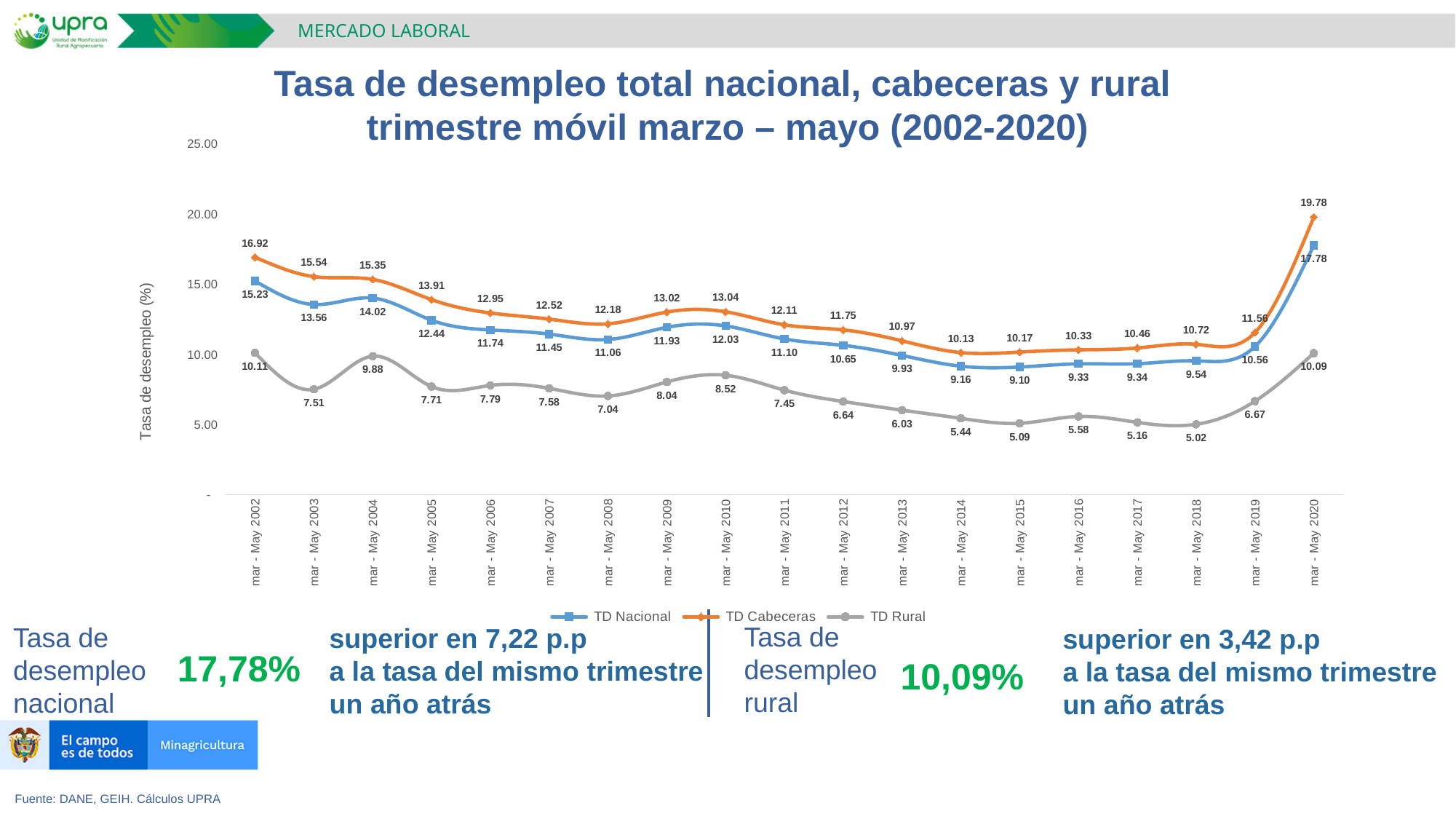
What kind of chart is shown on the slide? line chart By how much did TD Nacional increase from mar - May 2019 to mar - May 2020? 7.22 How many periods are plotted on the x axis? 19 Is the value of TD Cabeceras for mar - May 2002 greater or less than 15.00? greater What is the value of TD Rural for mar - May 2018? 5.02 How many series does the legend list? 3 What is the difference between TD Cabeceras and TD Nacional in mar - May 2020? 2.00 In which period does TD Nacional reach its highest value? mar - May 2020 What is the value of TD Cabeceras for mar - May 2020? 19.78 What is the value of TD Nacional for mar - May 2015? 9.10 Which is larger for TD Nacional: mar - May 2003 or mar - May 2004? mar - May 2004 In which period does TD Rural reach its lowest value? mar - May 2018